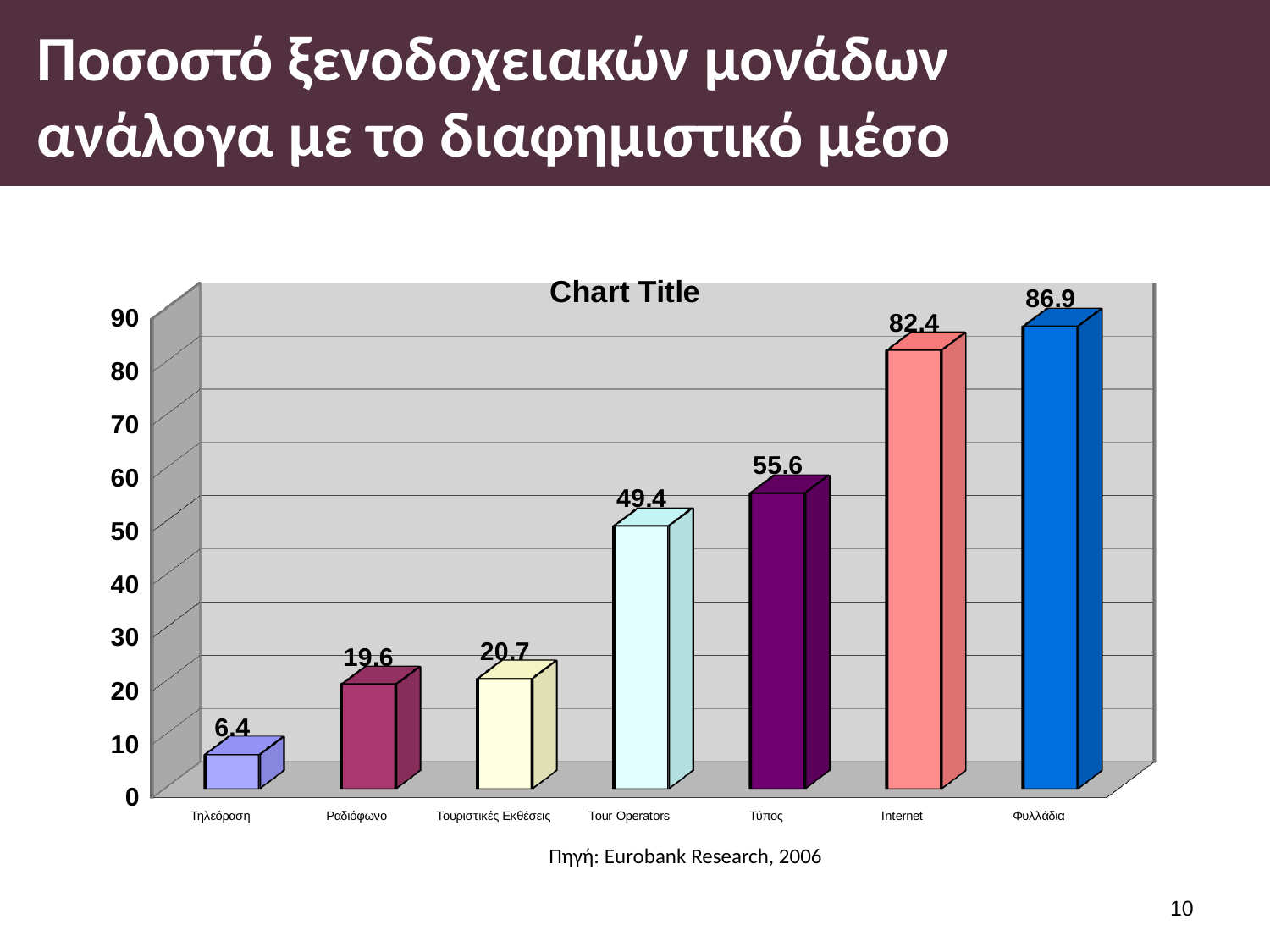
What is the value for Internet? 82.4 What is the difference between the values for Φυλλάδια and Internet? 4.5 How many categories are shown on the x axis? 7 What kind of chart is shown on the slide? bar chart What is the value for Τηλεόραση? 6.4 Is the value for Τύπος greater or less than 50? greater Which is larger, the value for Ραδιόφωνο or the value for Τουριστικές Εκθέσεις? Τουριστικές Εκθέσεις Which category has the lowest value? Τηλεόραση What is the difference between the values for Τύπος and Tour Operators? 6.2 Which category has the highest value? Φυλλάδια What is the value for Tour Operators? 49.4 What source is cited below the chart? Eurobank Research, 2006